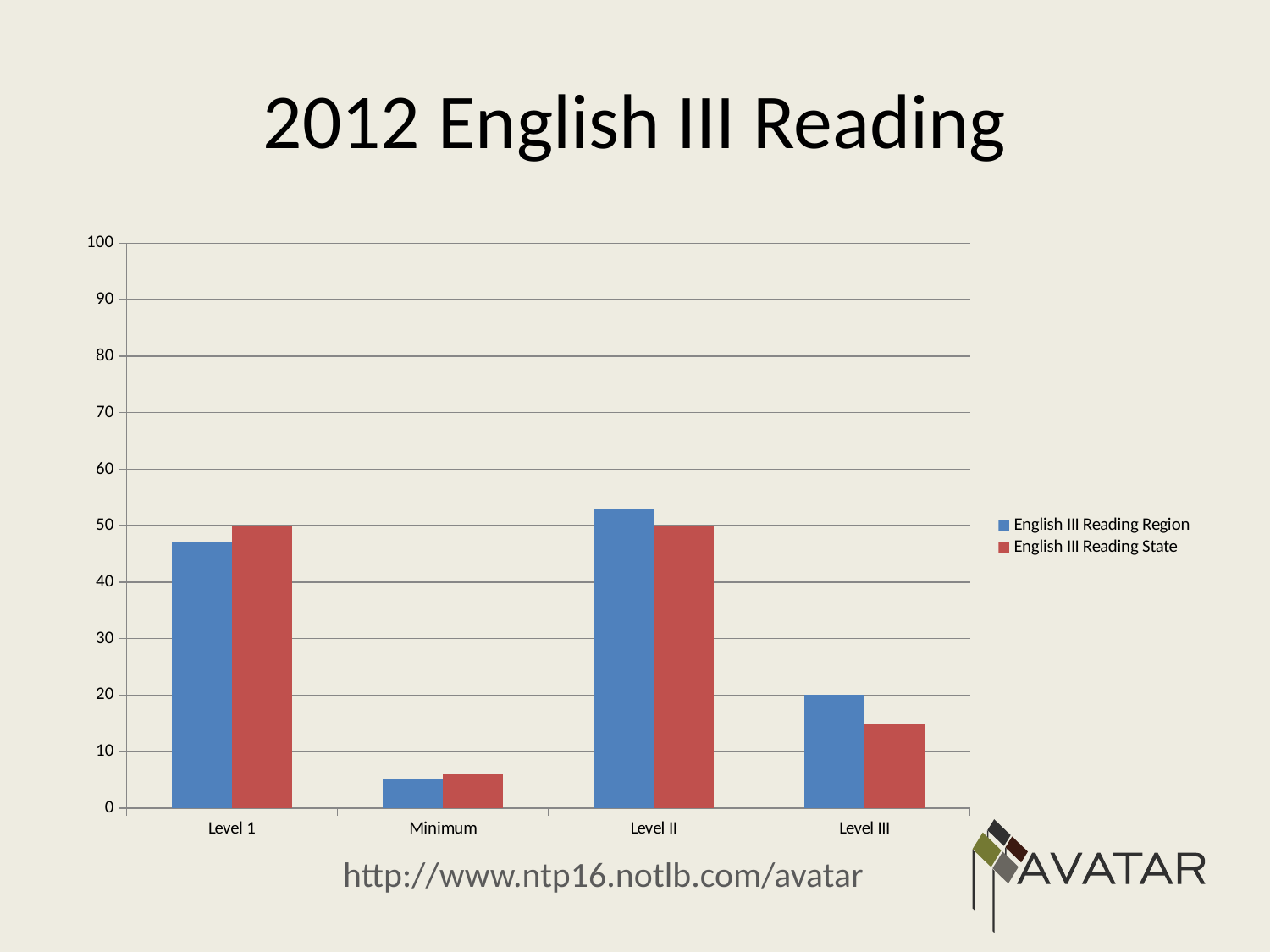
At Level III, which series has the larger value, English III Reading Region or English III Reading State? English III Reading Region What kind of chart is shown on the slide? bar chart Is the value for English III Reading Region at Level 1 greater or less than 50? less How many categories are shown on the x axis? 4 How many series does the legend list? 2 Which category has the highest English III Reading Region value? Level II What is the title of the chart? 2012 English III Reading Which category has the lowest English III Reading State value? Minimum Is the value for English III Reading Region at Level II greater or less than 50? greater What is the value for English III Reading State at Level 1? 50 What is the value for English III Reading Region at Level III? 20 Is the value for English III Reading State at Level III greater or less than 20? less